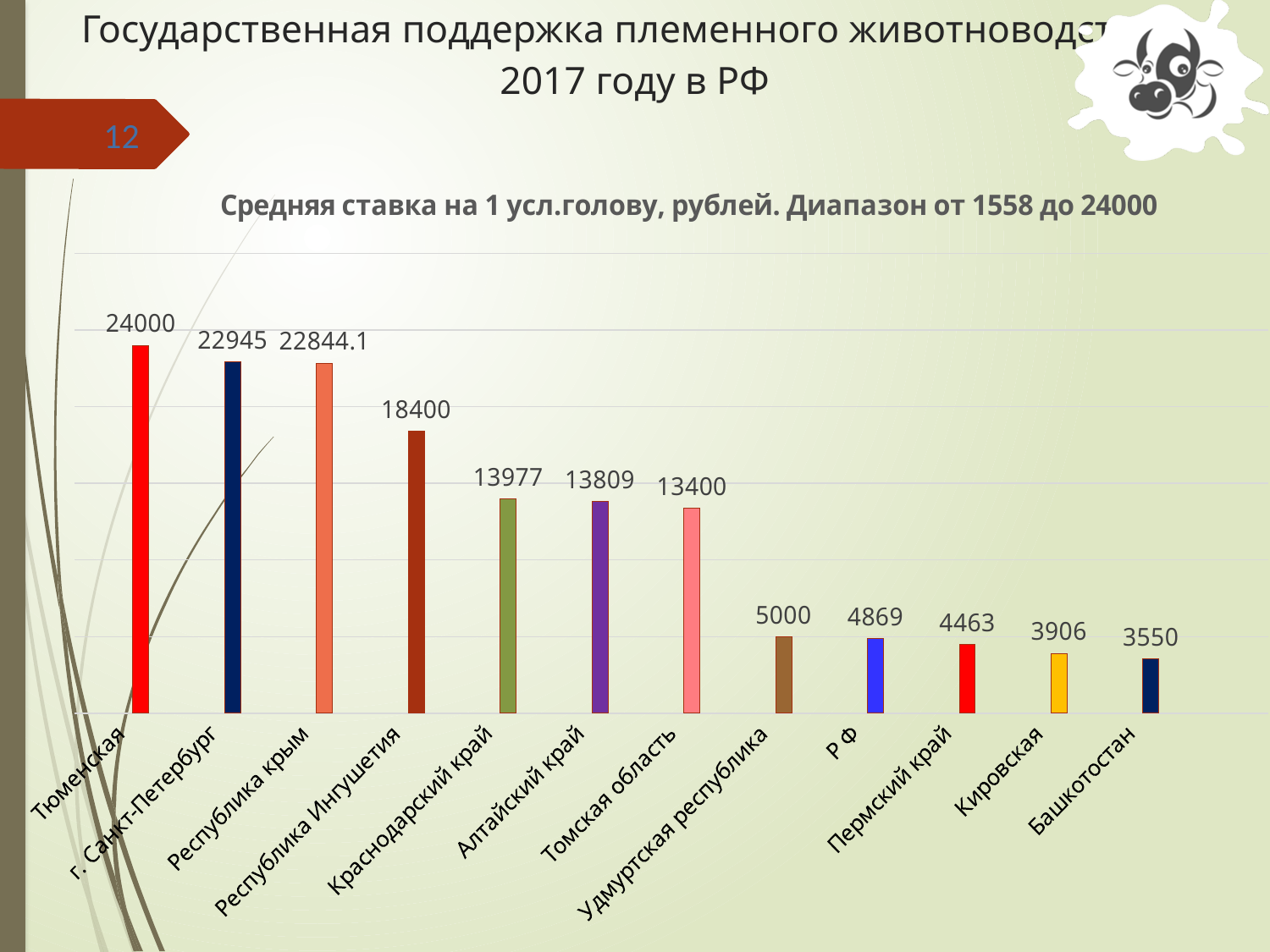
What is the value for Р Ф? 4869 What is the value for Тюменская? 24000 Do the values rise or fall from left to right along the x axis? Fall Which category has the highest value? Тюменская What is the difference between the values for Тюменская and г. Санкт-Петербург? 1055 What is the value for Республика Ингушетия? 18400 Which is larger, the value for Краснодарский край or the value for Томская область? Краснодарский край What kind of chart is shown on the slide? Bar chart What is the difference between the values for Удмуртская республика and Башкотостан? 1450 Which category has the lowest value? Башкотостан What is the value for Республика крым? 22844.1 How many categories are shown in the chart? 12